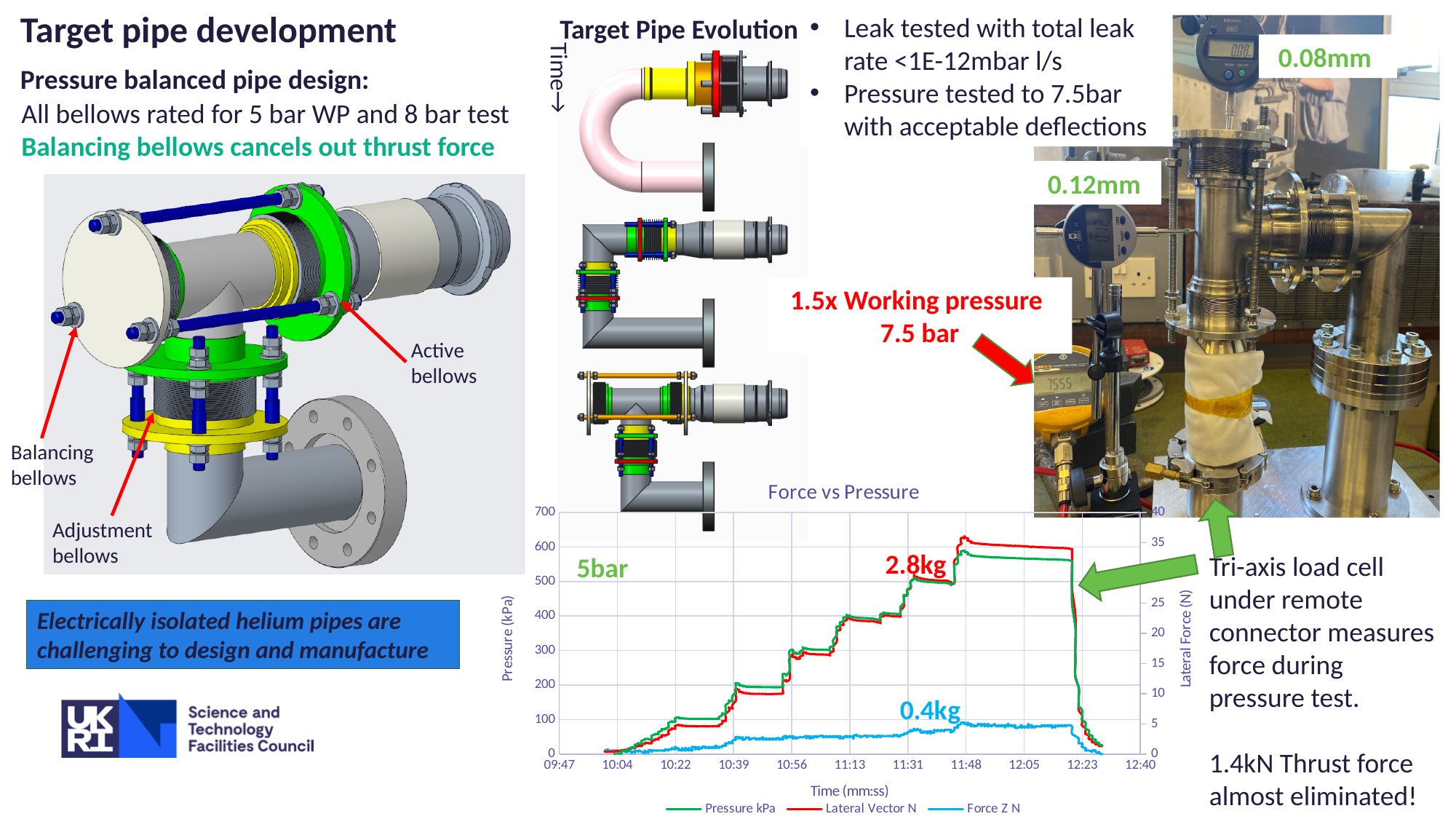
How many time tick labels are shown on the x axis of the Force vs Pressure chart? 11 In the Force vs Pressure chart, which series stays lowest on the plot throughout the test? Force Z N In the Force vs Pressure chart, is the peak of the Lateral Vector N series greater or less than 30 N on the right axis? greater In the Force vs Pressure chart, is the Pressure kPa value at 10:22 greater or less than 200 kPa? less In the Force vs Pressure chart, is the peak of the Force Z N series greater or less than 10 N on the right axis? less How many series does the legend of the Force vs Pressure chart list? 3 What are the three series listed in the legend of the Force vs Pressure chart? Pressure kPa, Lateral Vector N, Force Z N What kind of chart is the Force vs Pressure chart? line chart In the Force vs Pressure chart, does the Pressure kPa series generally rise or fall between 10:04 and 12:05? rise What is the title of the chart at the bottom centre of the slide? Force vs Pressure In the Force vs Pressure chart, is the Pressure kPa value at 11:48 larger or smaller than its value at 10:39? larger